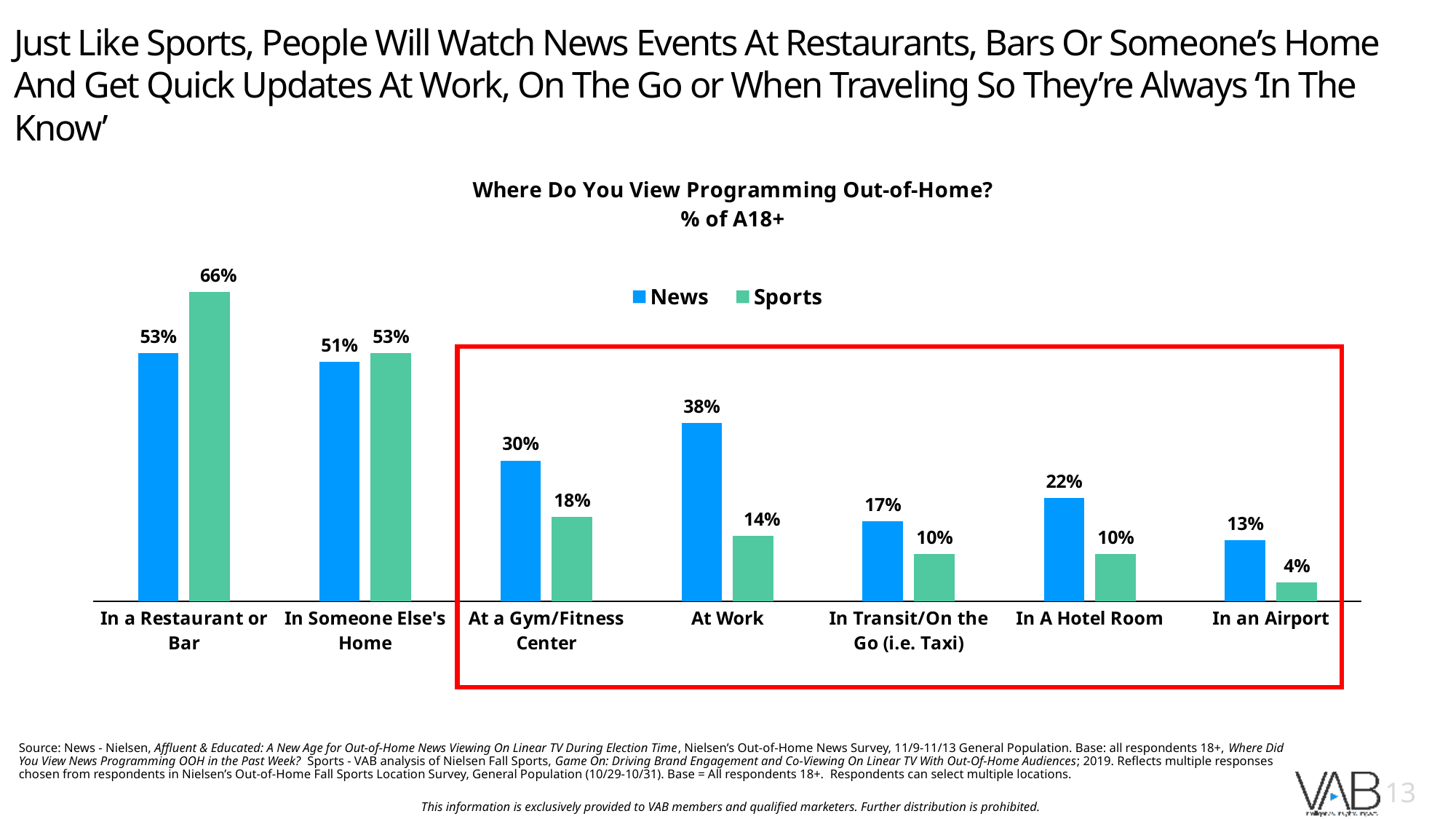
Which location has the highest Sports value? In a Restaurant or Bar What is the News value for 'In an Airport'? 13% How many location categories are shown on the x axis? 7 What is the difference between the News and Sports values for 'At Work'? 24% Which is larger for 'At a Gym/Fitness Center': the News value or the Sports value? News What percentage of A18+ view Sports programming out-of-home in a restaurant or bar? 66% What is the difference between the Sports and News values for 'In a Restaurant or Bar'? 13% What percentage of A18+ view News programming out-of-home at work? 38% Which location has the lowest News value? In an Airport What is the title of the chart? Where Do You View Programming Out-of-Home? % of A18+ What kind of chart is shown on the slide? Bar chart How many series does the legend list? 2